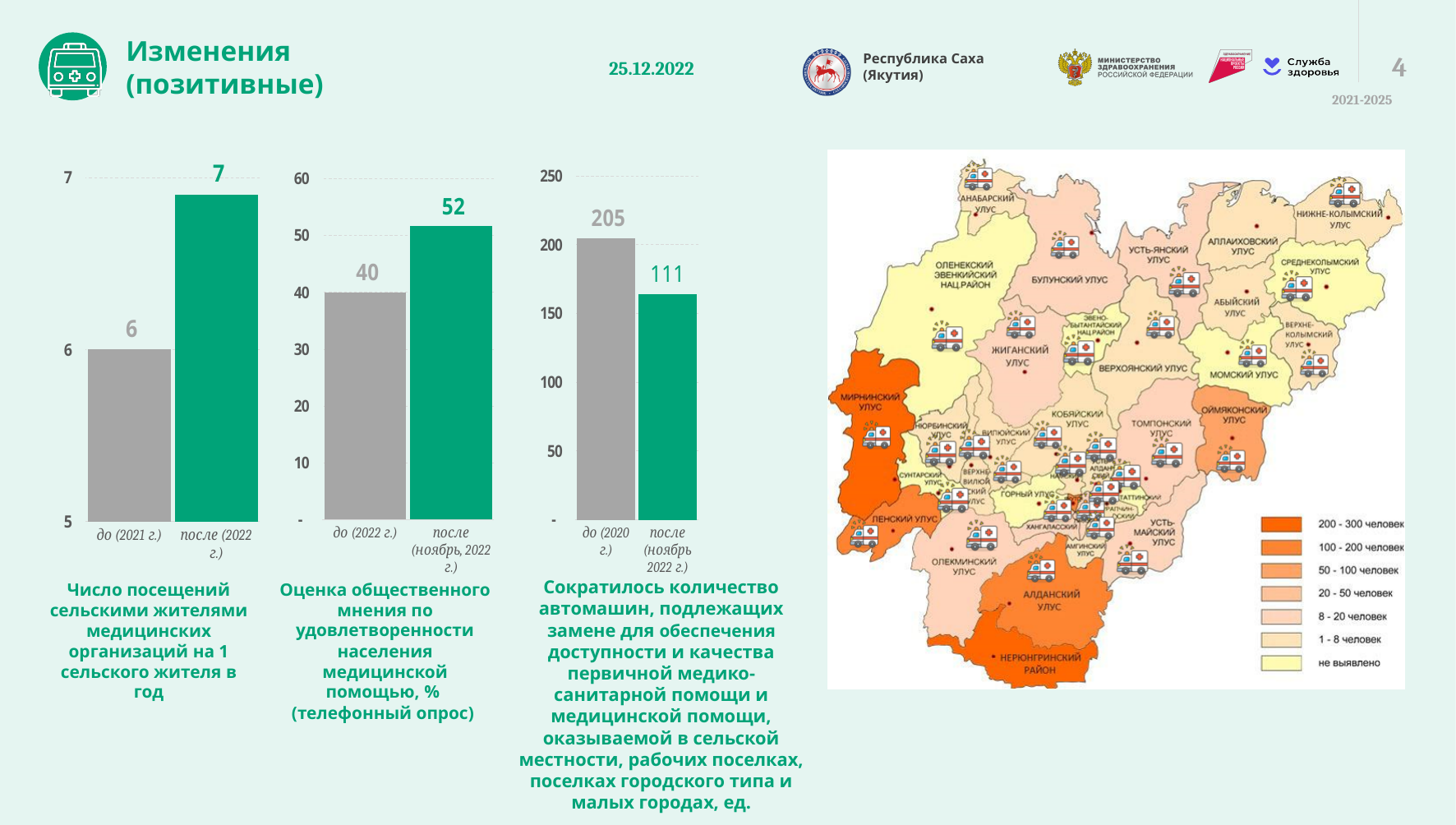
On the right chart (number of vehicles subject to replacement), what is the value for 'до (2020 г.)'? 205 On the left chart (number of visits by rural residents per rural resident per year), what is the value for 'до (2021 г.)'? 6 What type of chart is the left chart? bar chart On the right chart, which bar is higher: 'до (2020 г.)' or 'после (ноябрь 2022 г.)'? до (2020 г.) On the left chart (number of visits by rural residents per rural resident per year), what is the value for 'после (2022 г.)'? 7 On the middle chart, by how much did the value increase from 'до (2022 г.)' to 'после (ноябрь, 2022 г.)'? 12 On the right chart, is the value for 'до (2020 г.)' greater or less than 200? greater On the left chart, what is the difference between the 'после (2022 г.)' and 'до (2021 г.)' values? 1 How many bars does the middle chart have? 2 On the middle chart (public opinion on satisfaction with medical care, %), what is the value for 'после (ноябрь, 2022 г.)'? 52 On the middle chart (public opinion on satisfaction with medical care, %), what is the value for 'до (2022 г.)'? 40 On the right chart (number of vehicles subject to replacement), what is the value for 'после (ноябрь 2022 г.)'? 111